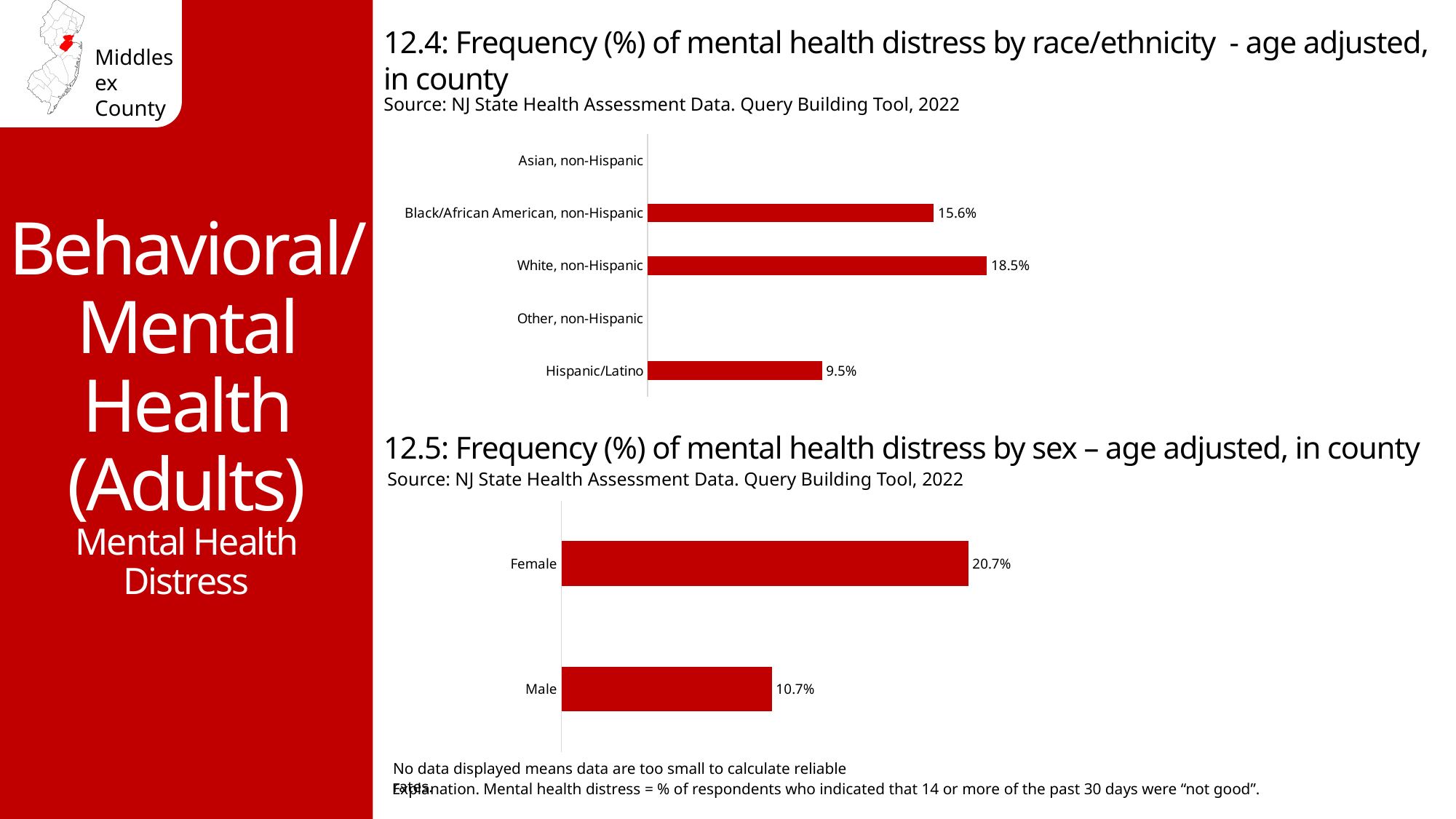
In chart 12.5 (mental health distress by sex), what is the difference between the Female and Male values? 10.0% What kind of chart is chart 12.5 (mental health distress by sex)? Bar chart In chart 12.4 (mental health distress by race/ethnicity), how many categories have a bar displayed? 3 In chart 12.4 (mental health distress by race/ethnicity), which race/ethnicity group has the highest value? White, non-Hispanic In chart 12.4 (mental health distress by race/ethnicity), how many race/ethnicity categories are listed on the axis? 5 In chart 12.4 (mental health distress by race/ethnicity), what is the value for Hispanic/Latino? 9.5% In chart 12.4 (mental health distress by race/ethnicity), what is the value for Black/African American, non-Hispanic? 15.6% In chart 12.5 (mental health distress by sex), what is the value for Female? 20.7% In chart 12.4 (mental health distress by race/ethnicity), what is the difference between the White, non-Hispanic and Hispanic/Latino values? 9.0% In chart 12.5 (mental health distress by sex), what is the value for Male? 10.7% In chart 12.4 (mental health distress by race/ethnicity), what is the value for White, non-Hispanic? 18.5% In chart 12.5 (mental health distress by sex), which is larger, the Female value or the Male value? Female